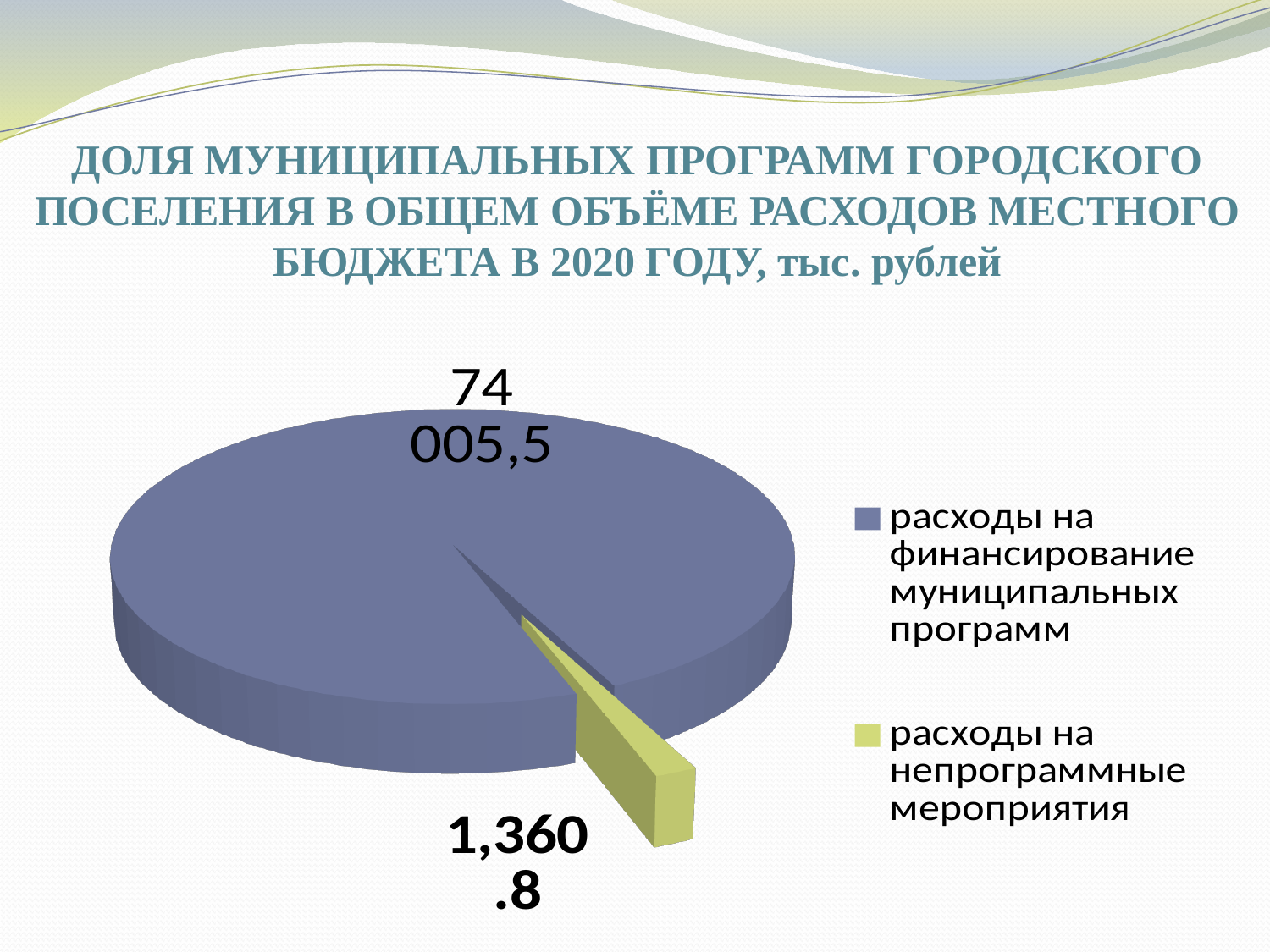
Which is larger: расходы на финансирование муниципальных программ or расходы на непрограммные мероприятия? расходы на финансирование муниципальных программ What value is shown for расходы на непрограммные мероприятия? 1,360.8 What value is shown for расходы на финансирование муниципальных программ? 74 005,5 Which category has the smallest slice of the pie? расходы на непрограммные мероприятия How many entries does the legend list? 2 In what units are the values on the chart expressed, according to the slide title? тыс. рублей Which category has the largest slice of the pie? расходы на финансирование муниципальных программ How many slices does the pie chart have? 2 What colour is the slice for расходы на непрограммные мероприятия? yellow-green What kind of chart is shown on the slide? pie chart